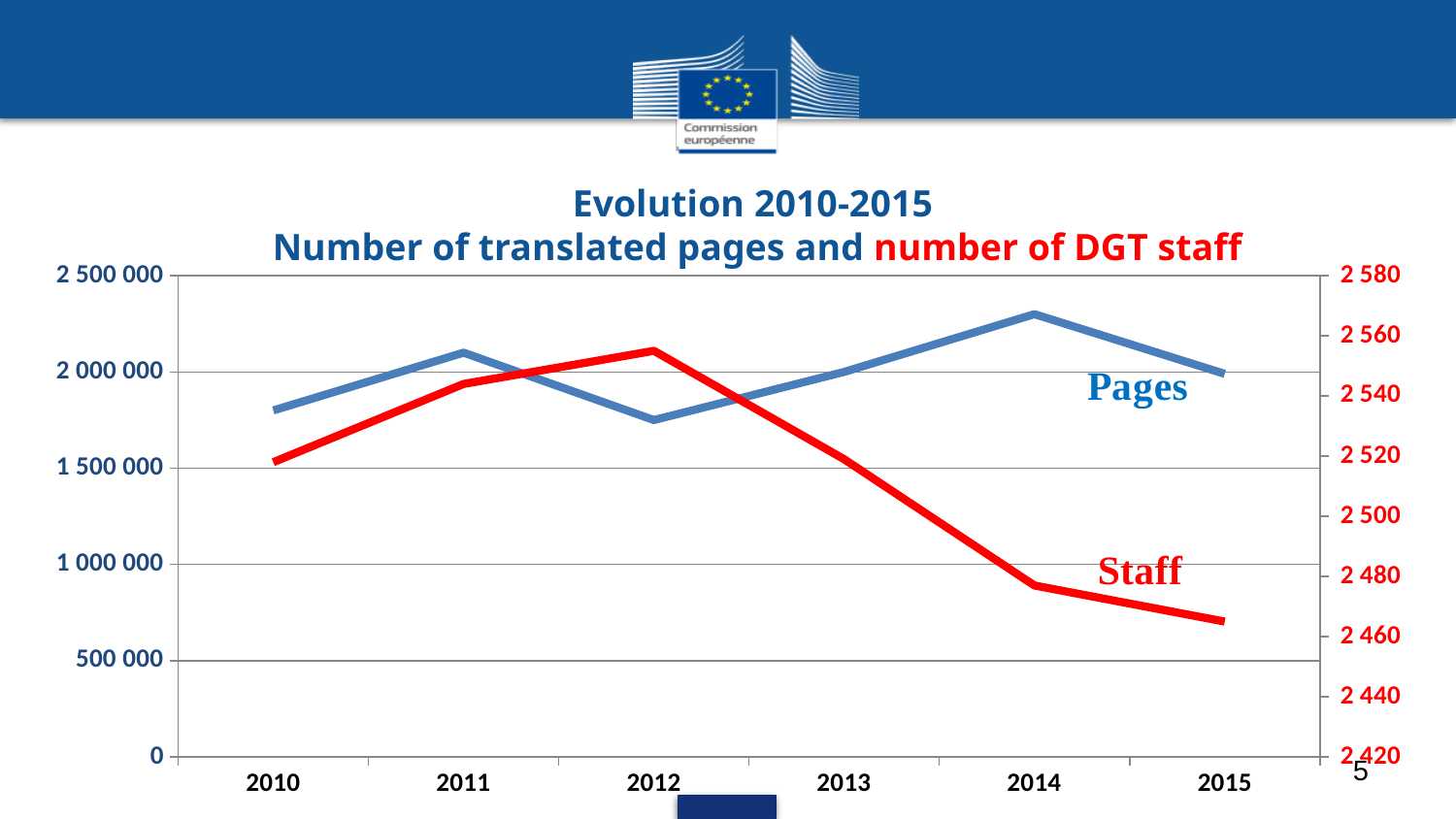
Which year has more DGT staff, 2011 or 2014? 2011 How many years are shown on the x axis of the chart? 6 How many series are plotted on the chart? 2 In which year is the number of DGT staff highest? 2012 Is the number of translated pages in 2012 greater or less than 2 000 000? less Is the number of DGT staff in 2015 greater or less than 2 480? less In which year is the number of DGT staff lowest? 2015 In which year is the number of translated pages highest? 2014 Is the number of DGT staff in 2012 greater or less than 2 540? greater Does the number of DGT staff rise or fall from 2012 to 2015? fall What kind of chart is shown on the slide? line chart